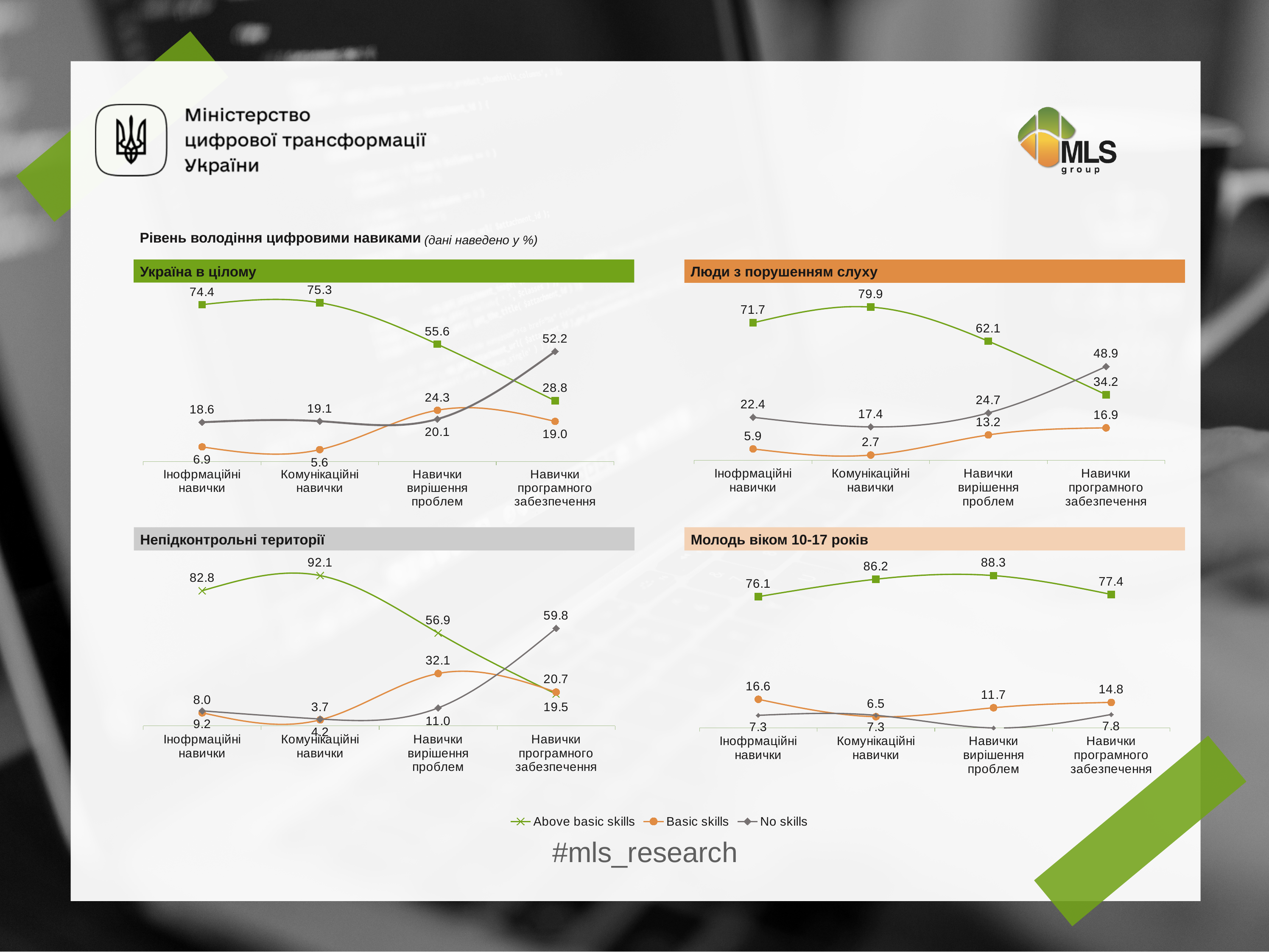
In the "Люди з порушенням слуху" chart, what is the value of Basic skills for Комунікаційні навички? 2.7 In the "Непідконтрольні території" chart, which category has the lowest No skills value? Комунікаційні навички How many categories are shown on the x axis of the "Україна в цілому" chart? 4 How many series does the legend list? 3 In the "Україна в цілому" chart, what is the value of Above basic skills for Інформаційні навички? 74.4 In the "Молодь віком 10-17 років" chart, which is larger: Basic skills for Інформаційні навички or Basic skills for Навички програмного забезпечення? Інформаційні навички In the "Україна в цілому" chart, does the Above basic skills series rise or fall from Комунікаційні навички to Навички програмного забезпечення? Fall In the "Молодь віком 10-17 років" chart, what is the value of Above basic skills for Навички вирішення проблем? 88.3 In the "Люди з порушенням слуху" chart, which category has the highest Above basic skills value? Комунікаційні навички What kind of chart is the "Люди з порушенням слуху" chart? Line chart In the "Непідконтрольні території" chart, what is the difference between the Above basic skills values for Комунікаційні навички and Навички програмного забезпечення? 72.6 In the "Україна в цілому" chart, what is the value of No skills for Навички програмного забезпечення? 52.2